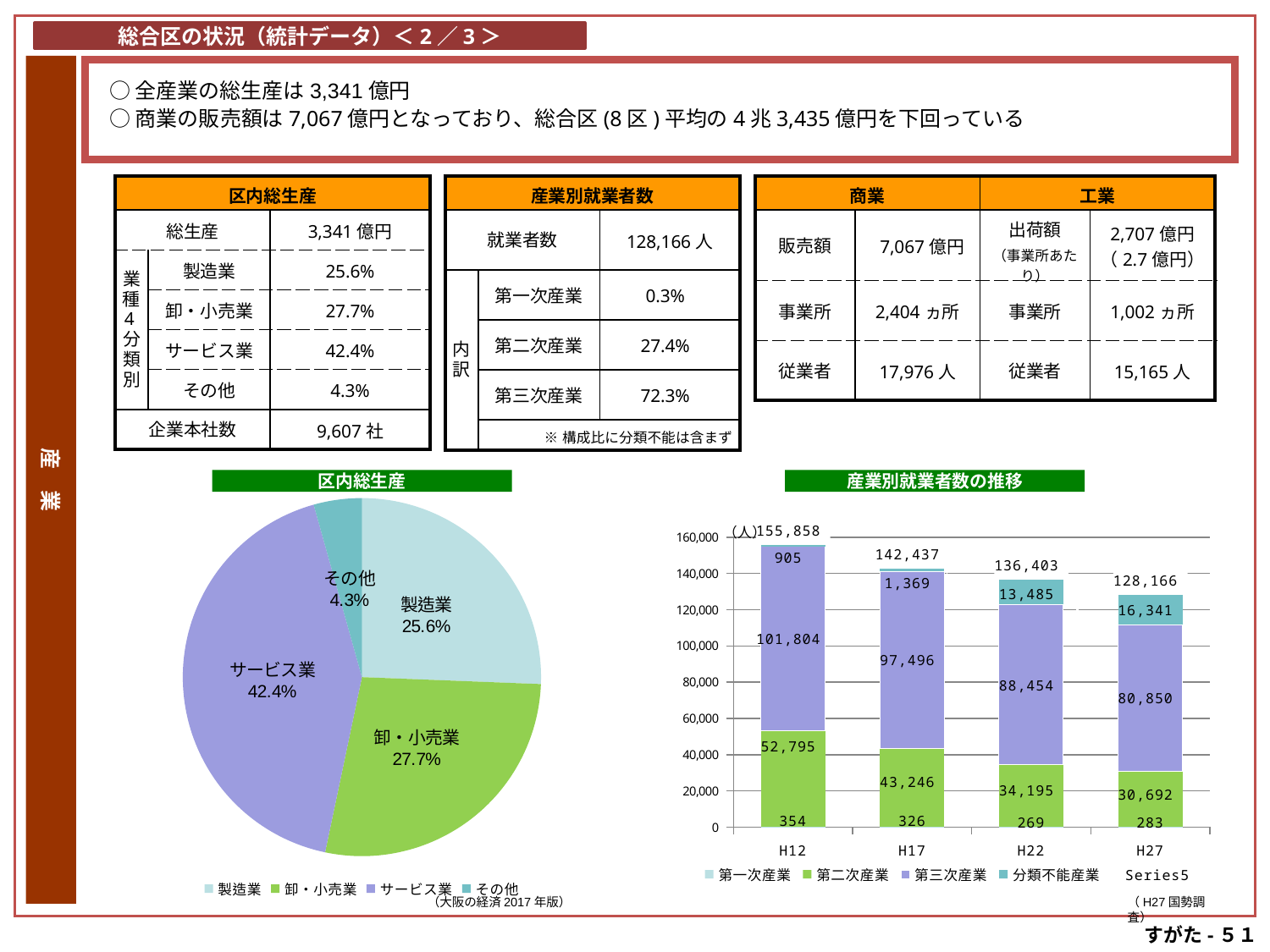
In the pie chart titled 区内総生産, what is the difference between the shares of 卸・小売業 and 製造業? 2.1% In the pie chart titled 区内総生産, how many slices are there? 4 In the pie chart titled 区内総生産, which category has the largest share? サービス業 In the chart titled 産業別就業者数の推移, what is the value for 第三次産業 in H17? 97,496 In the chart titled 産業別就業者数の推移, what is the total of the stacked bar for H22? 136,403 In the pie chart titled 区内総生産, which category has the smallest share? その他 What kind of chart is the chart titled 産業別就業者数の推移? stacked bar chart In the chart titled 産業別就業者数の推移, do the bar totals rise or fall from H12 to H27? fall In the chart titled 産業別就業者数の推移, which is larger: 分類不能産業 in H22 or in H27? H27 In the pie chart titled 区内総生産, what share does サービス業 have? 42.4% In the chart titled 産業別就業者数の推移, which year has the lowest total? H27 In the chart titled 産業別就業者数の推移, what is the difference between the 第二次産業 values for H12 and H27? 22,103